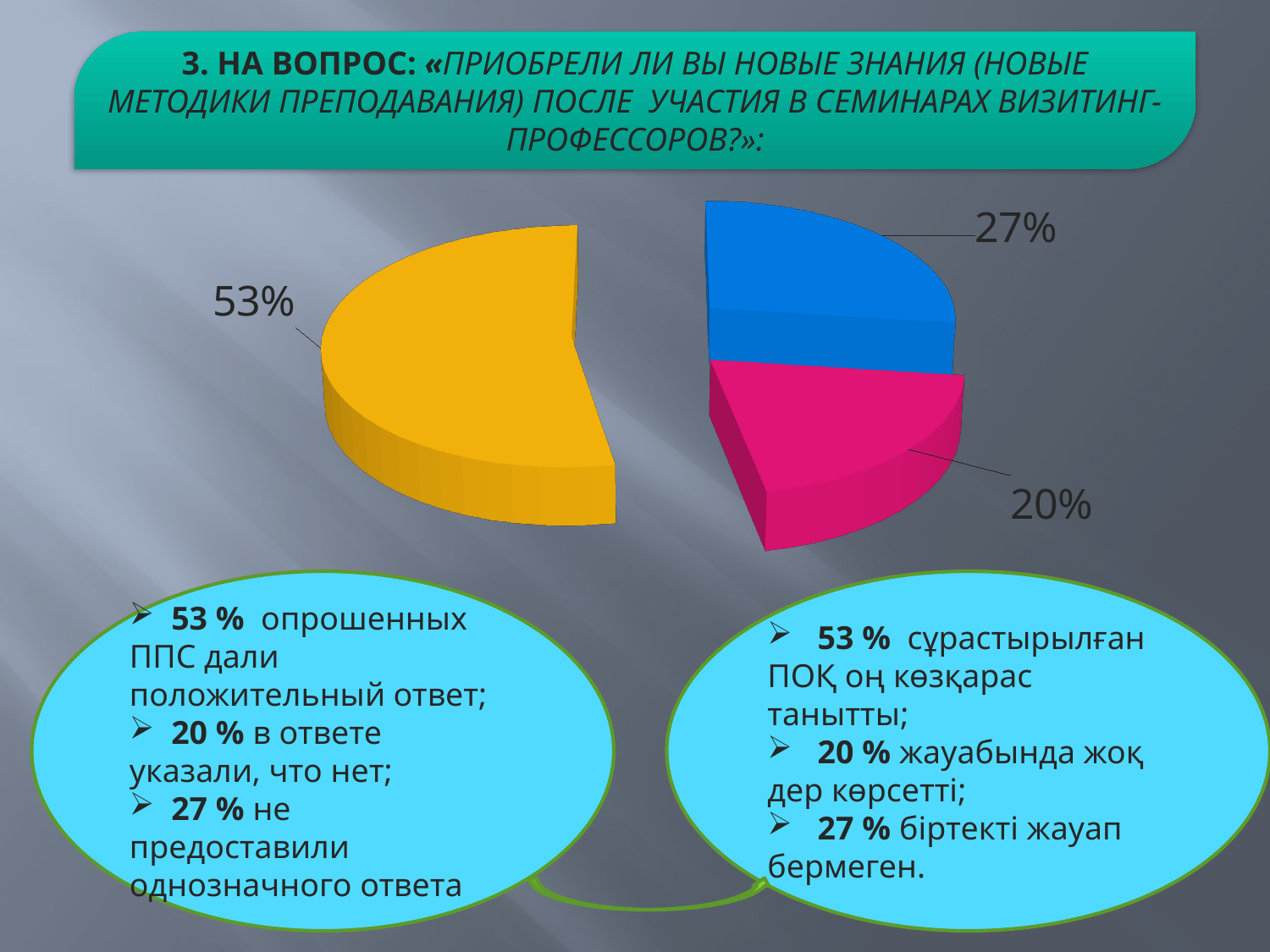
What is the value shown for the pink slice of the pie chart? 20% What colour is the slice labelled 27% in the pie chart? blue What kind of chart is shown on the slide? pie chart Is the value of the yellow slice greater or less than 50%? greater What is the value shown for the yellow slice of the pie chart? 53% Which slice of the pie chart is the largest? the yellow slice (53%) Which is larger in the pie chart, the blue slice or the pink slice? the blue slice What is the difference between the largest and smallest slices of the pie chart? 33% Which slice of the pie chart is the smallest? the pink slice (20%) How many slices does the pie chart have? 3 What is the difference between the blue slice and the pink slice of the pie chart? 7% What is the value shown for the blue slice of the pie chart? 27%